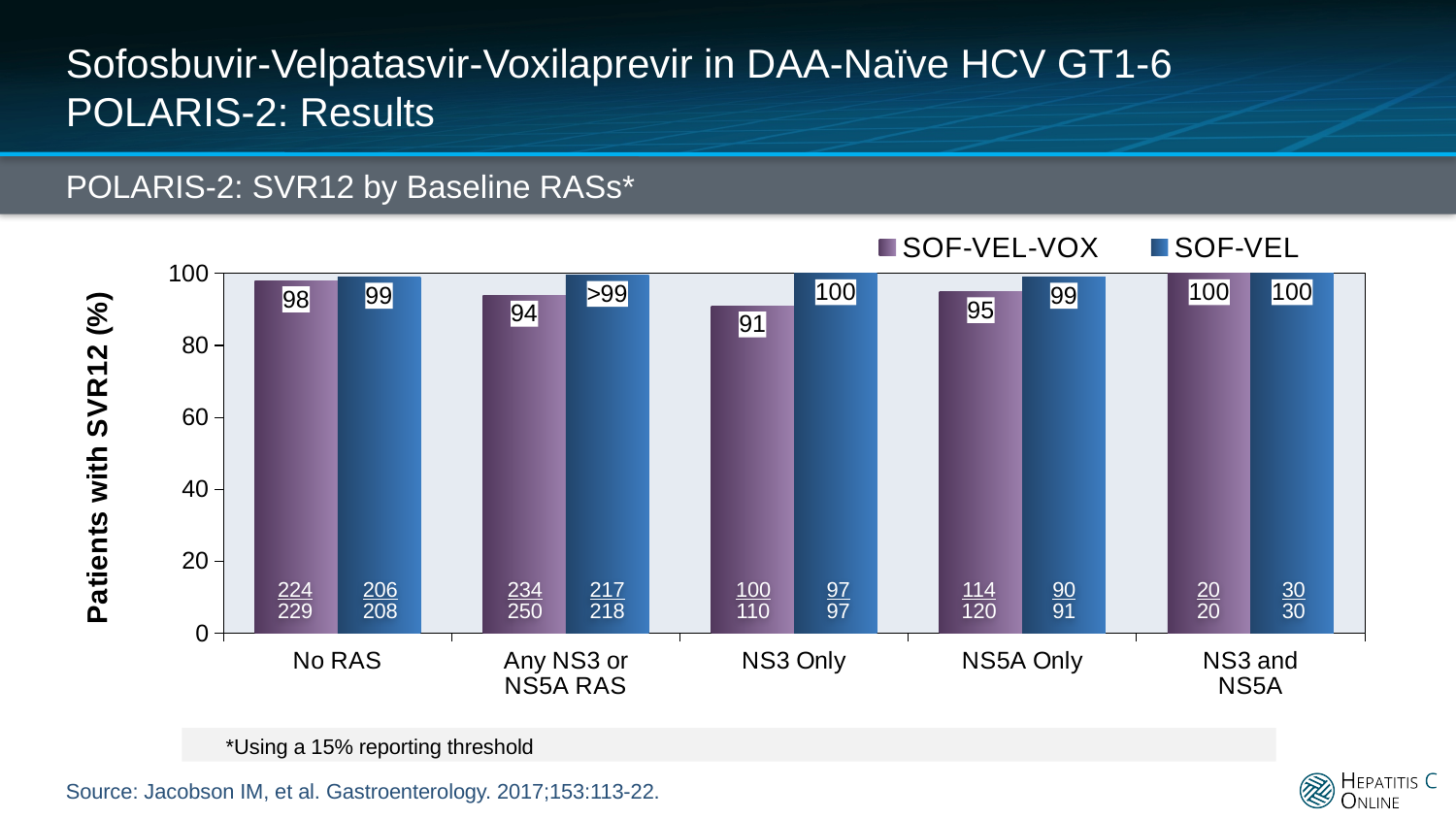
How many patients achieved SVR12 out of how many treated with SOF-VEL-VOX in the NS3 and NS5A group? 20/20 How many baseline RAS categories are shown on the x axis? 5 Which baseline RAS group has the lowest SVR12 rate for SOF-VEL-VOX? NS3 Only In the NS5A Only group, which regimen has the higher SVR12 rate, SOF-VEL-VOX or SOF-VEL? SOF-VEL What is the difference between the SOF-VEL and SOF-VEL-VOX SVR12 rates in the NS3 Only group? 9 How many series does the legend list? 2 What is the label of the y axis? Patients with SVR12 (%) What is the SVR12 rate for SOF-VEL-VOX in the No RAS group? 98 What kind of chart is shown on the slide? Bar chart What is the SVR12 rate for SOF-VEL in the NS5A Only group? 99 What is the SVR12 rate for SOF-VEL-VOX in the NS3 Only group? 91 What is the SVR12 rate for SOF-VEL in the Any NS3 or NS5A RAS group? >99